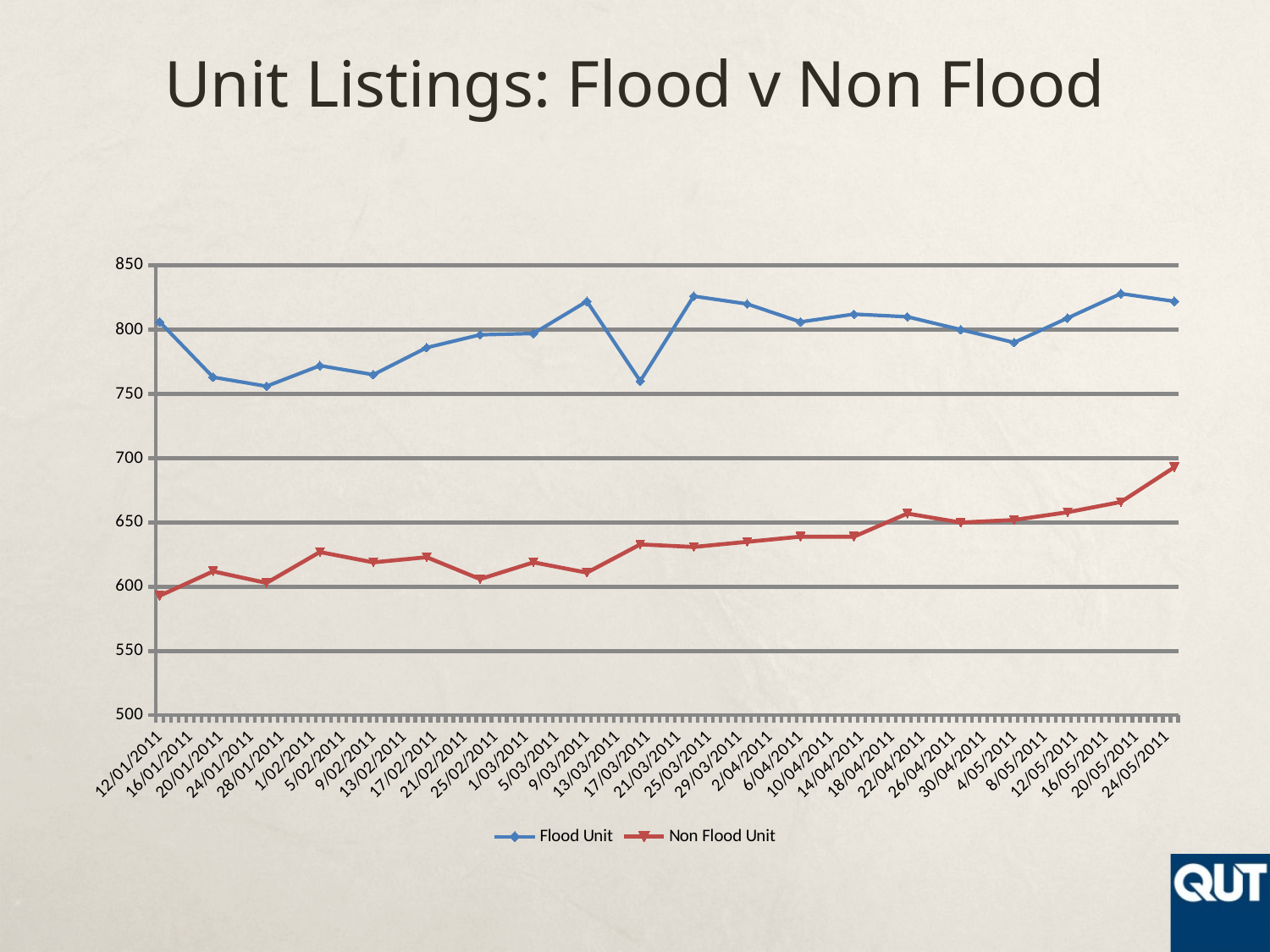
How many dates are shown along the x axis? 34 Does the Non Flood Unit series generally rise or fall from 12/01/2011 to 24/05/2011? Rise Which series is drawn in red? Non Flood Unit On 24/05/2011, which series has the larger value, Flood Unit or Non Flood Unit? Flood Unit Is the value for Non Flood Unit on 24/05/2011 greater or less than 650? greater Is the value for Non Flood Unit on 1/02/2011 greater or less than 650? less Is the value for Flood Unit on 9/03/2011 greater or less than 800? greater On which date does the Non Flood Unit series reach its highest value? 24/05/2011 What kind of chart is shown on the slide? Line chart What is the title of the chart? Unit Listings: Flood v Non Flood How many series does the legend list? 2